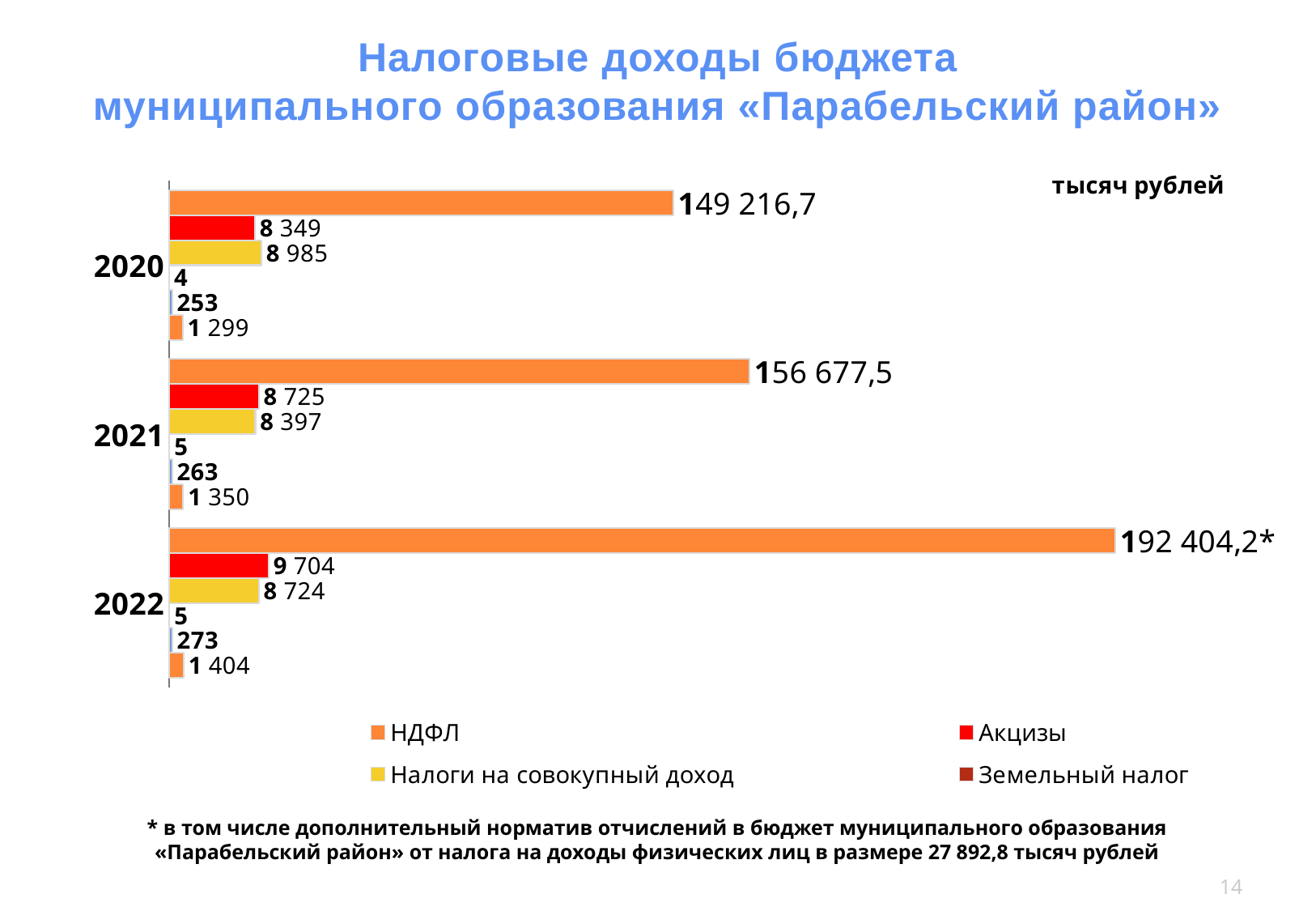
What is the value of НДФЛ for 2022? 192 404,2 How many years are shown on the chart? 3 What is the value of НДФЛ for 2020? 149 216,7 What is the value of Налоги на совокупный доход for 2021? 8 397 Does НДФЛ rise or fall from 2020 to 2022? rise How many series does the legend list? 4 In which year is НДФЛ the highest? 2022 Which is larger in 2020: Акцизы or Налоги на совокупный доход? Налоги на совокупный доход What is the difference between НДФЛ in 2022 and in 2021? 35 726,7 What is the difference between Акцизы in 2022 and in 2021? 979 In which year is Акцизы the lowest? 2020 What is the value of Акцизы for 2022? 9 704